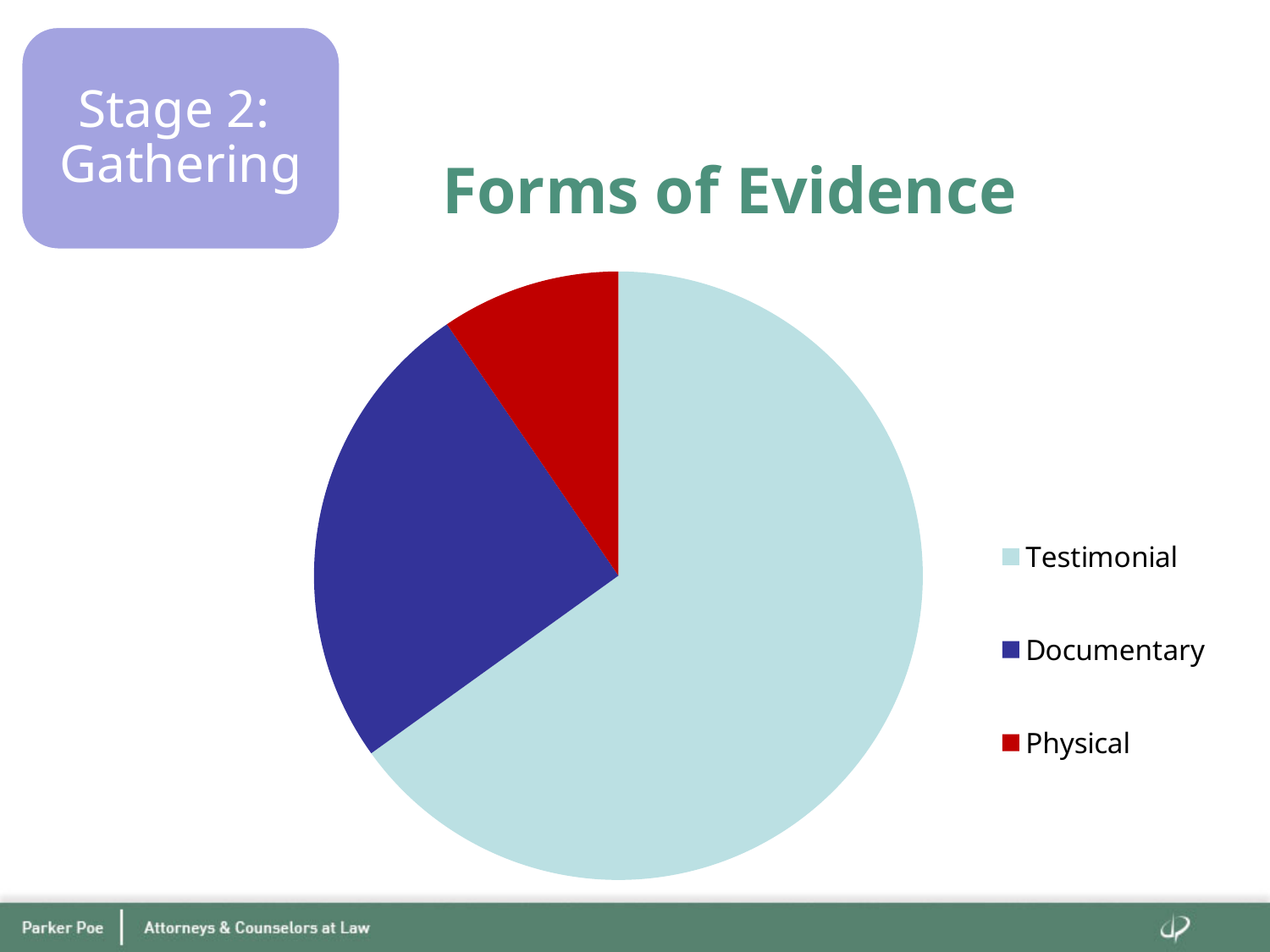
Does the Testimonial slice make up more or less than half of the pie? more What is the title of the chart? Forms of Evidence How many categories does the pie chart show? 3 What kind of chart is shown on the slide? pie chart Which slice is larger, Testimonial or Documentary? Testimonial Which category has the largest slice of the pie? Testimonial Which category is shown in red in the pie chart? Physical Which slice is larger, Documentary or Physical? Documentary Which category has the smallest slice of the pie? Physical